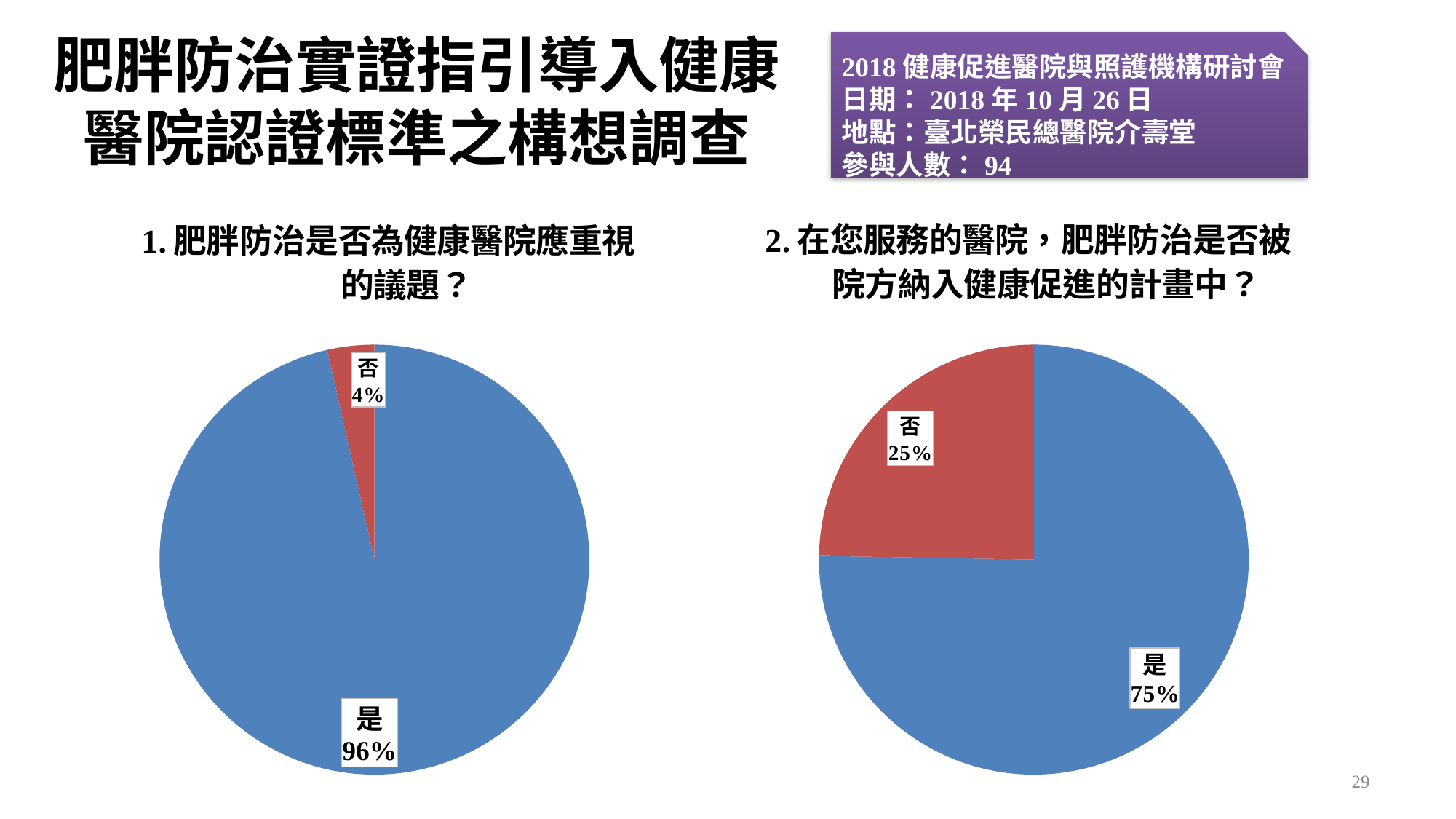
In the right pie chart (question 2), what colour is the 否 slice? Red In the left pie chart (question 1), what is the difference between the 是 and 否 shares? 92% In the left pie chart (question 1), which answer has the largest slice? 是 Which is larger: the 否 share in the left pie chart (question 1) or the 否 share in the right pie chart (question 2)? The right pie chart (question 2) In the right pie chart (question 2), what is the difference between the 是 and 否 shares? 50% In the right pie chart (question 2), which answer has the smallest slice? 否 In the left pie chart (question 1), what share of respondents answered 否? 4% In the left pie chart (question 1), what share of respondents answered 是? 96% In the right pie chart (question 2), what share of respondents answered 否? 25% In the right pie chart (question 2), what share of respondents answered 是? 75% How many slices does the right pie chart (question 2) have? 2 What kind of chart is used for question 1 on the left? Pie chart